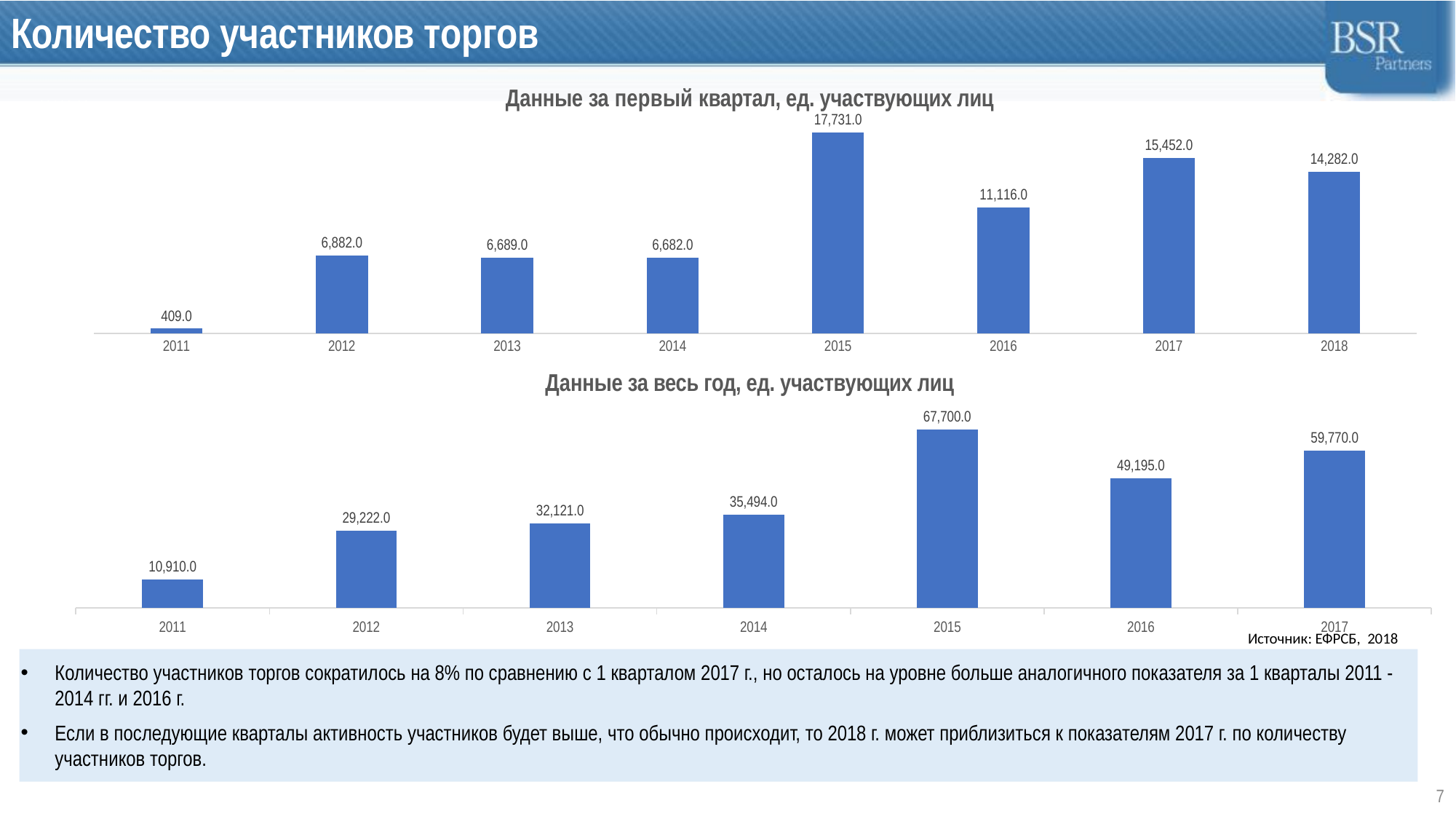
What type of chart is the bottom chart 'Данные за весь год, ед. участвующих лиц'? Bar chart In the chart 'Данные за первый квартал, ед. участвующих лиц', which year has the highest value? 2015 In the chart 'Данные за весь год, ед. участвующих лиц', how many years are shown? 7 In the chart 'Данные за первый квартал, ед. участвующих лиц', what is the difference between the values for 2017 and 2018? 1,170.0 In the chart 'Данные за первый квартал, ед. участвующих лиц', what is the value for 2015? 17,731.0 In the chart 'Данные за первый квартал, ед. участвующих лиц', which year has the lowest value? 2011 In the chart 'Данные за первый квартал, ед. участвующих лиц', what is the value for 2018? 14,282.0 In the chart 'Данные за весь год, ед. участвующих лиц', what is the value for 2016? 49,195.0 In the chart 'Данные за первый квартал, ед. участвующих лиц', how many years are shown? 8 In the chart 'Данные за весь год, ед. участвующих лиц', which year has the highest value? 2015 In the chart 'Данные за весь год, ед. участвующих лиц', what is the difference between the values for 2015 and 2017? 7,930.0 In the chart 'Данные за весь год, ед. участвующих лиц', which is larger, the value for 2012 or the value for 2013? 2013